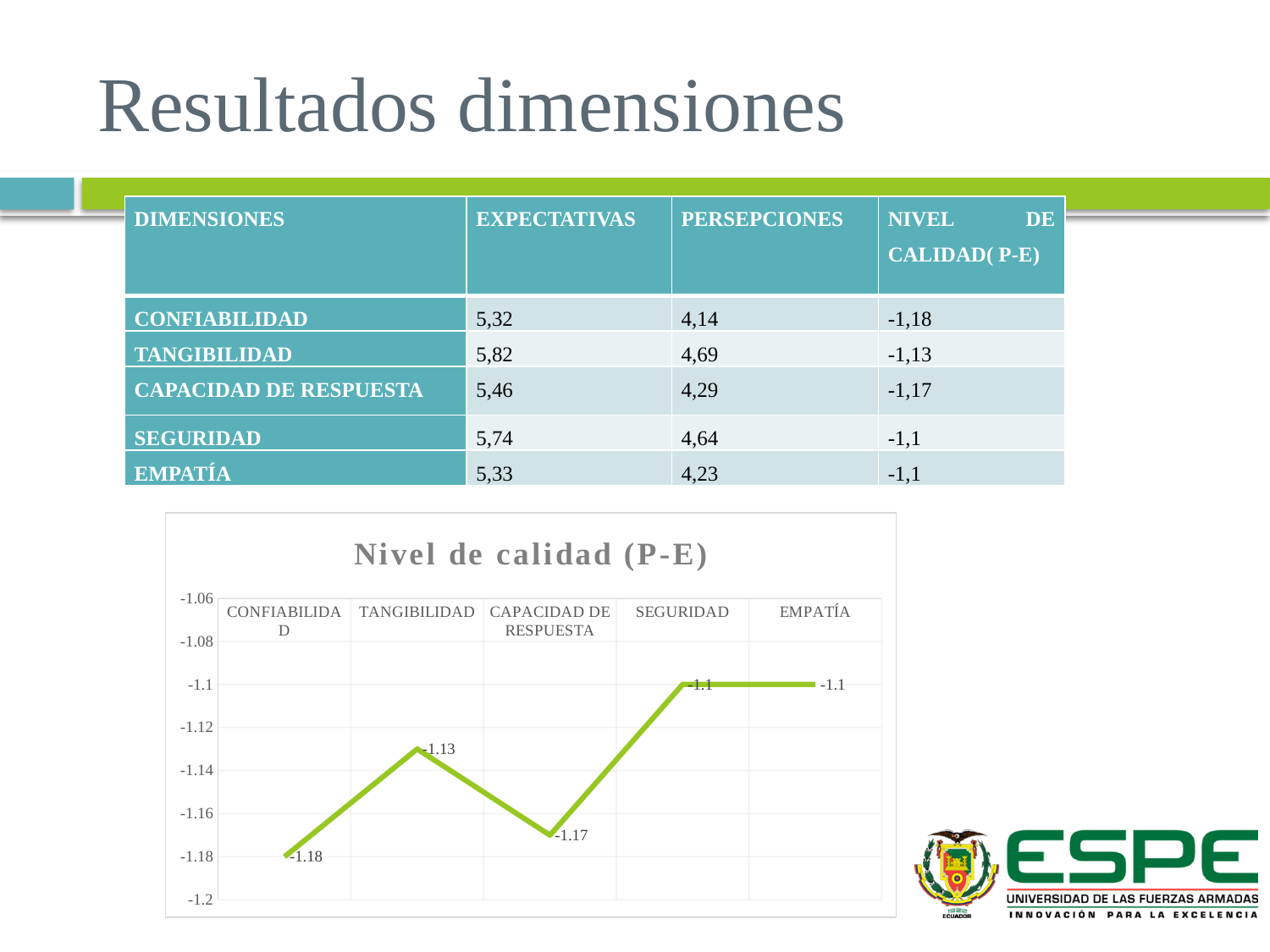
What is the difference between the values for TANGIBILIDAD and CONFIABILIDAD? 0.05 What is the value for CAPACIDAD DE RESPUESTA in the chart? -1.17 What is the value for SEGURIDAD in the chart? -1.1 Does the value rise or fall from CONFIABILIDAD to TANGIBILIDAD? rise Is the value for CONFIABILIDAD greater or less than -1.16? less Which category has the lowest value in the chart? CONFIABILIDAD Which is larger, the value for TANGIBILIDAD or the value for CAPACIDAD DE RESPUESTA? TANGIBILIDAD What kind of chart is shown on the slide? line chart How many categories are plotted in the chart? 5 What is the title of the chart? Nivel de calidad (P-E) What is the value for CONFIABILIDAD in the chart? -1.18 What is the value for TANGIBILIDAD in the chart? -1.13